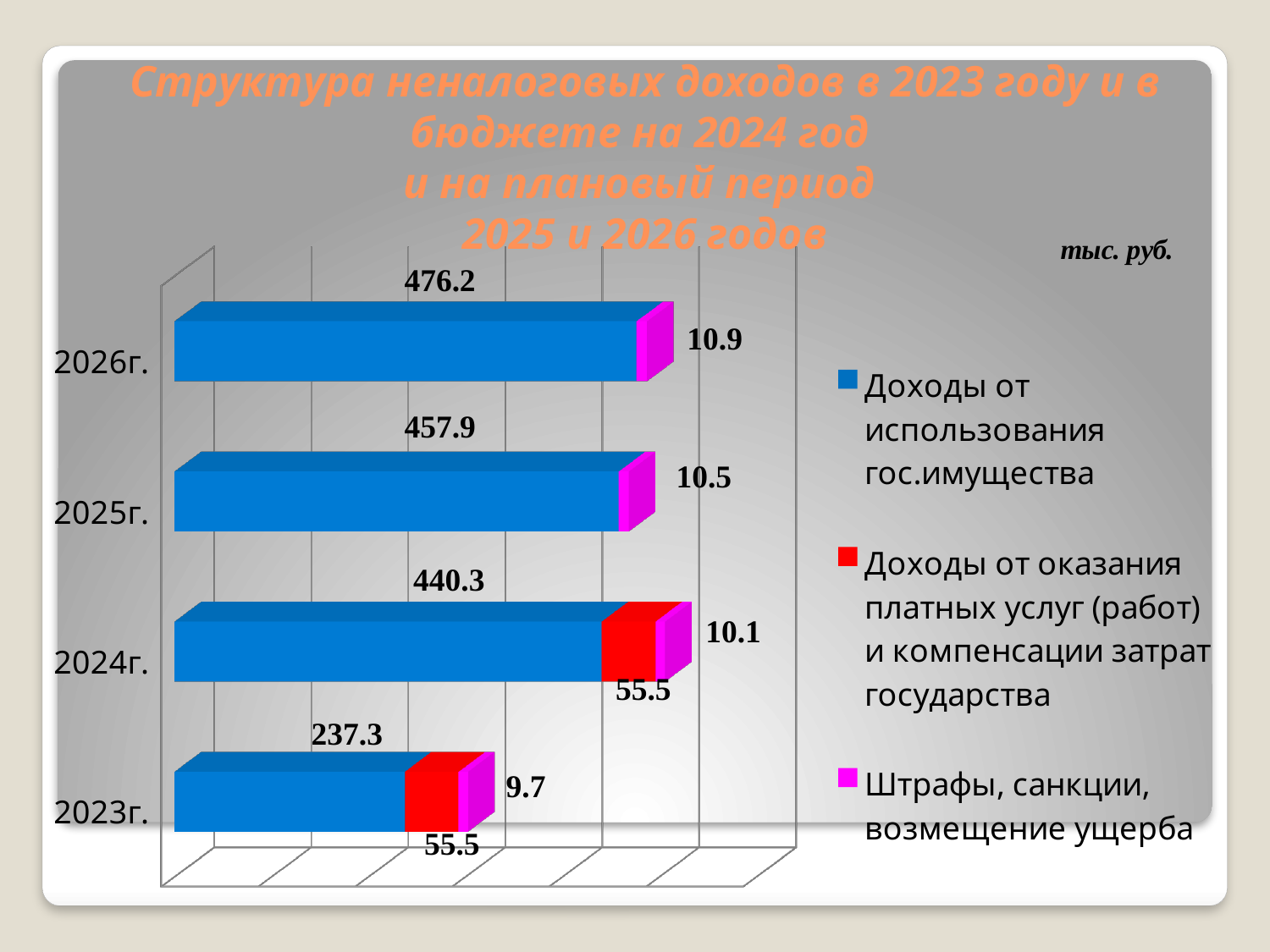
Which year has the highest value for 'Доходы от использования гос.имущества'? 2026г. What is the value of 'Штрафы, санкции, возмещение ущерба' for 2023г.? 9.7 What kind of chart is shown on the slide? Stacked bar chart What is the value of 'Доходы от использования гос.имущества' for 2026г.? 476.2 What is the difference between the 'Доходы от использования гос.имущества' values for 2024г. and 2023г.? 203.0 Which is larger: 'Доходы от использования гос.имущества' for 2025г. or for 2024г.? 2025г. How many series does the legend list? 3 What is the value of 'Доходы от оказания платных услуг (работ) и компенсации затрат государства' for 2024г.? 55.5 How many years (categories) are shown on the chart? 4 What unit is indicated for the chart values? тыс. руб. Which year has the lowest value for 'Штрафы, санкции, возмещение ущерба'? 2023г. What is the total of the stacked bar for 2024г.? 505.9